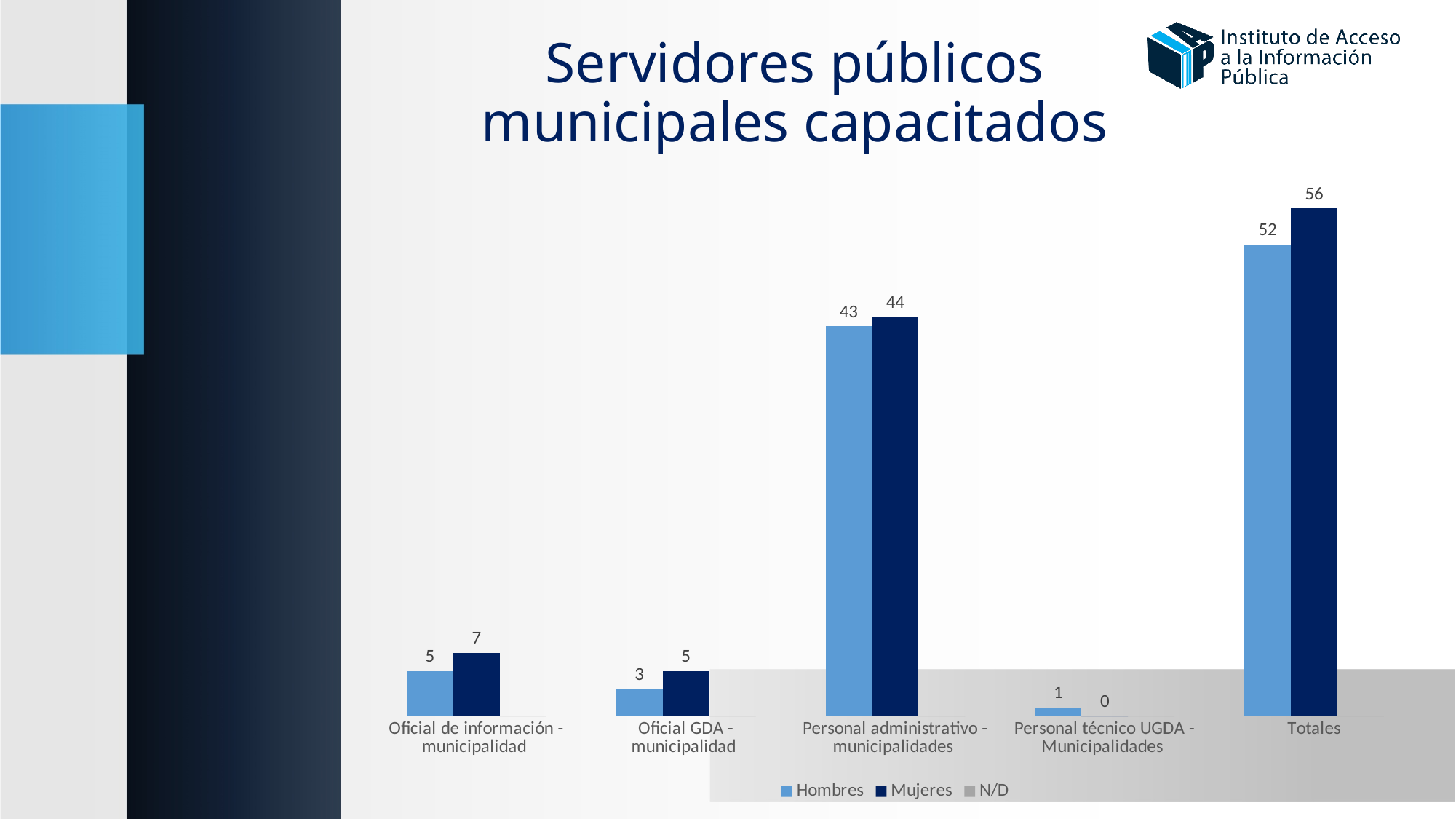
What is the Hombres value for Personal técnico UGDA - Municipalidades? 1 What kind of chart is shown on the slide? Bar chart Which is larger for Oficial GDA - municipalidad, the Hombres value or the Mujeres value? Mujeres What is the difference between the Mujeres and Hombres values for Totales? 4 Which category has the lowest Mujeres value? Personal técnico UGDA - Municipalidades What is the Mujeres value for Oficial de información - municipalidad? 7 What is the title of the chart on the slide? Servidores públicos municipales capacitados How many series does the legend list? 3 What is the Mujeres value for Totales? 56 Excluding Totales, which category has the highest Mujeres value? Personal administrativo - municipalidades How many categories are shown on the x axis? 5 What is the Hombres value for Personal administrativo - municipalidades? 43